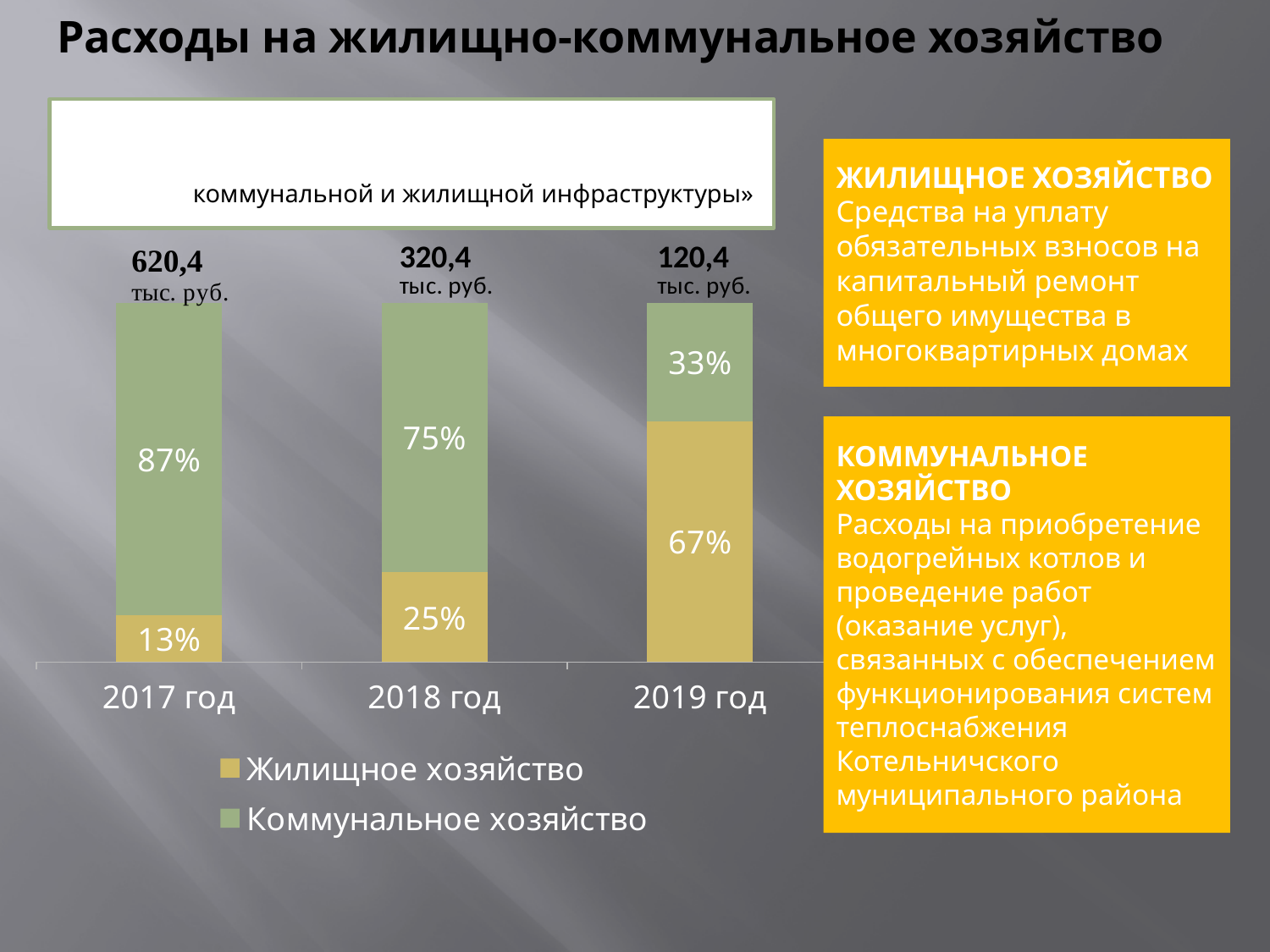
In which year is the share of Жилищное хозяйство the highest? 2019 год What kind of chart is shown on the slide? Stacked bar chart How many series does the legend list? 2 What total amount is printed above the 2019 год bar? 120,4 тыс. руб. What total amount is printed above the 2017 год bar? 620,4 тыс. руб. What share does Жилищное хозяйство have in the 2019 год bar? 67% Which is larger in 2019 год: the share of Жилищное хозяйство or Коммунальное хозяйство? Жилищное хозяйство What share does Коммунальное хозяйство have in the 2018 год bar? 75% How many years are shown on the x axis of the chart? 3 What share does Жилищное хозяйство have in the 2017 год bar? 13% What is the difference between the Коммунальное хозяйство share in 2017 год and in 2018 год? 12% In which year is the share of Коммунальное хозяйство the lowest? 2019 год